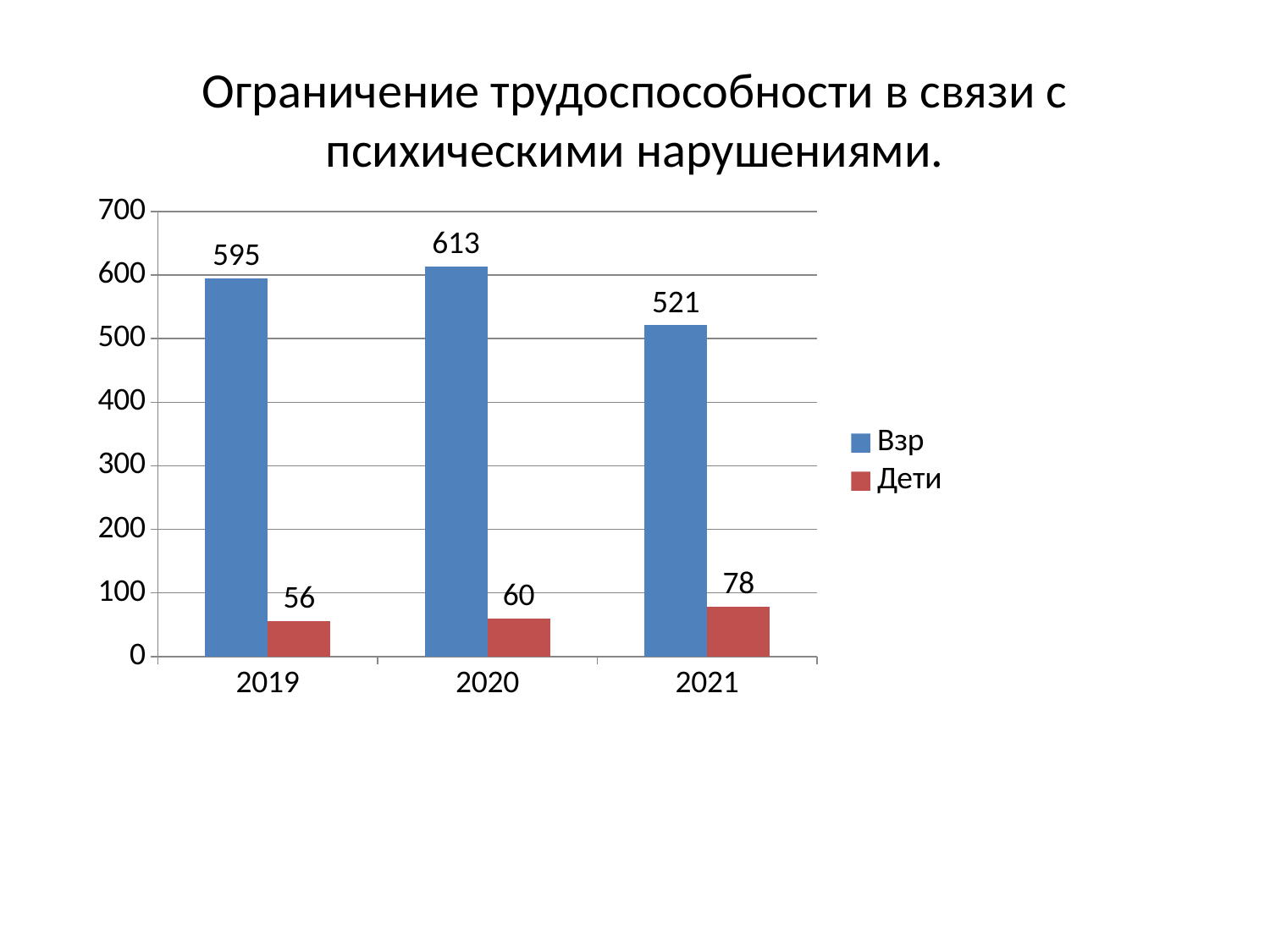
In which year is the Взр value highest? 2020 How many series does the legend list? 2 Which is larger, the Дети value for 2020 or for 2021? 2021 Do the Дети values rise or fall from 2019 to 2021? rise What kind of chart is shown on the slide? bar chart In which year is the Дети value lowest? 2019 Is the value for Взр in 2021 greater or less than 600? less What is the value for Дети in 2021? 78 How many years are shown on the x axis? 3 What is the value for Взр in 2020? 613 What is the value for Взр in 2019? 595 What is the difference between the Взр values for 2020 and 2021? 92